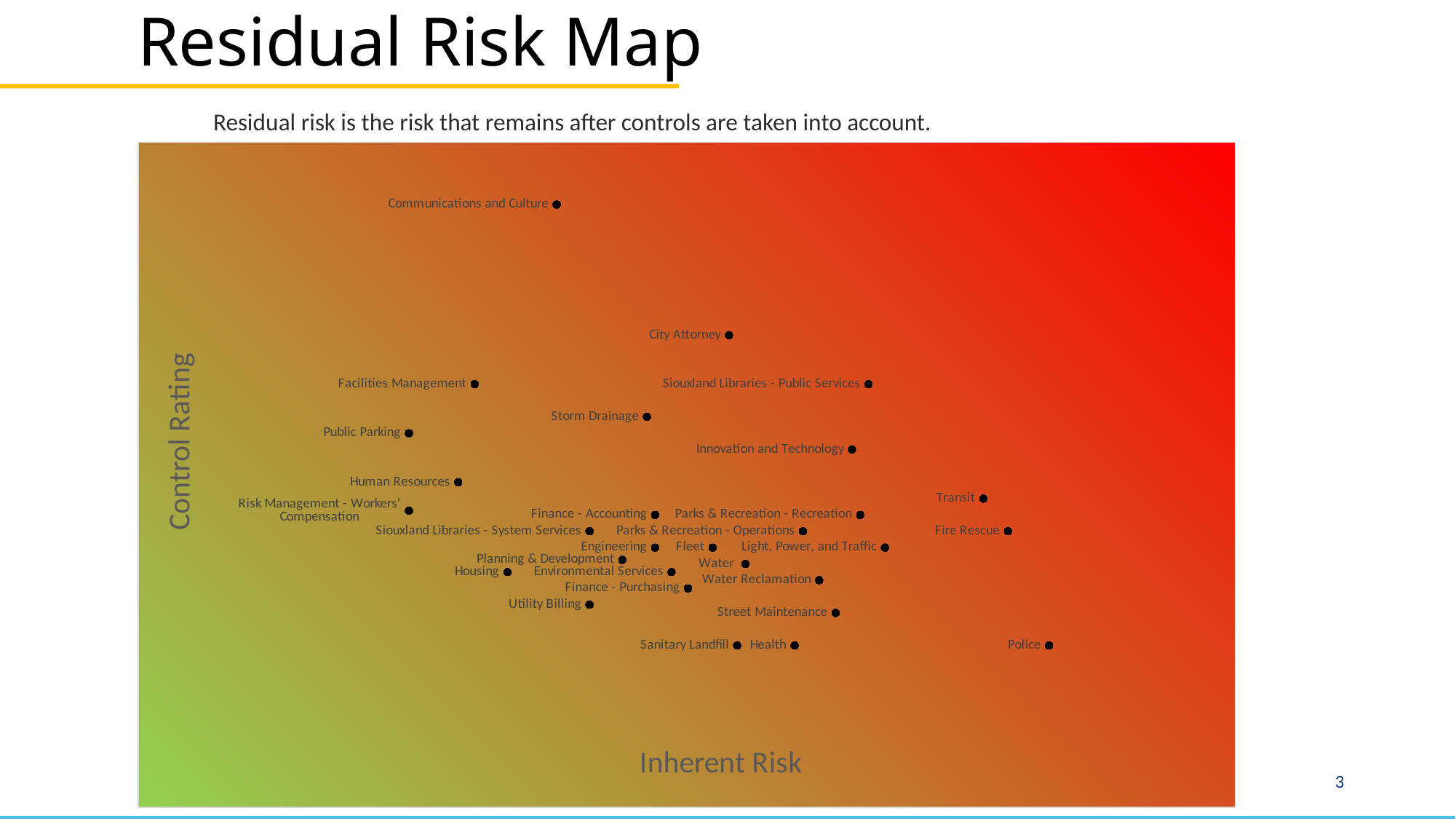
Which is plotted further right on the Inherent Risk axis, Public Parking or Fire Rescue? Fire Rescue Which is plotted higher on the Control Rating axis, Communications and Culture or City Attorney? Communications and Culture What is the title of the chart on the slide? Residual Risk Map What kind of chart is shown on the slide? Scatter chart Which is plotted further right on the Inherent Risk axis, Police or Transit? Police Which department is plotted highest on the Control Rating axis? Communications and Culture What is the label of the horizontal axis of the chart? Inherent Risk How many departments are plotted as points on the chart? 29 Which department is plotted furthest to the right on the Inherent Risk axis? Police